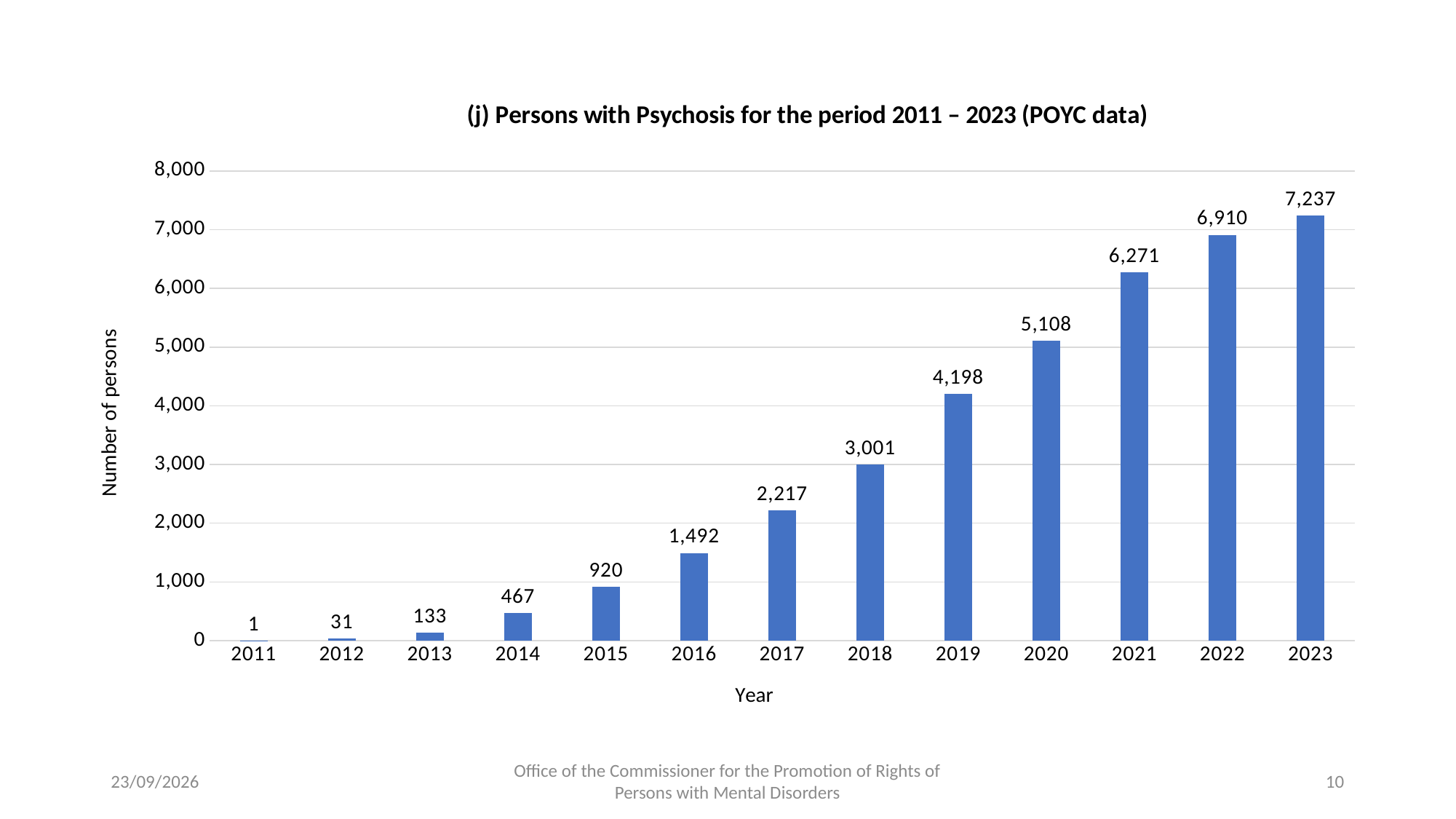
What is the number of persons with psychosis in 2015? 920 Which year has the highest number of persons with psychosis? 2023 What is the number of persons with psychosis in 2023? 7,237 What kind of chart is shown on the slide? Bar chart Do the values rise or fall from 2011 to 2023? Rise Is the value for 2021 greater or less than 6,000? greater How many years are shown on the x axis? 13 What is the difference between the number of persons in 2020 and in 2019? 910 Which year has more persons with psychosis, 2016 or 2017? 2017 What is the difference between the number of persons in 2022 and in 2021? 639 Which year has the lowest number of persons with psychosis? 2011 What is the number of persons with psychosis in 2018? 3,001